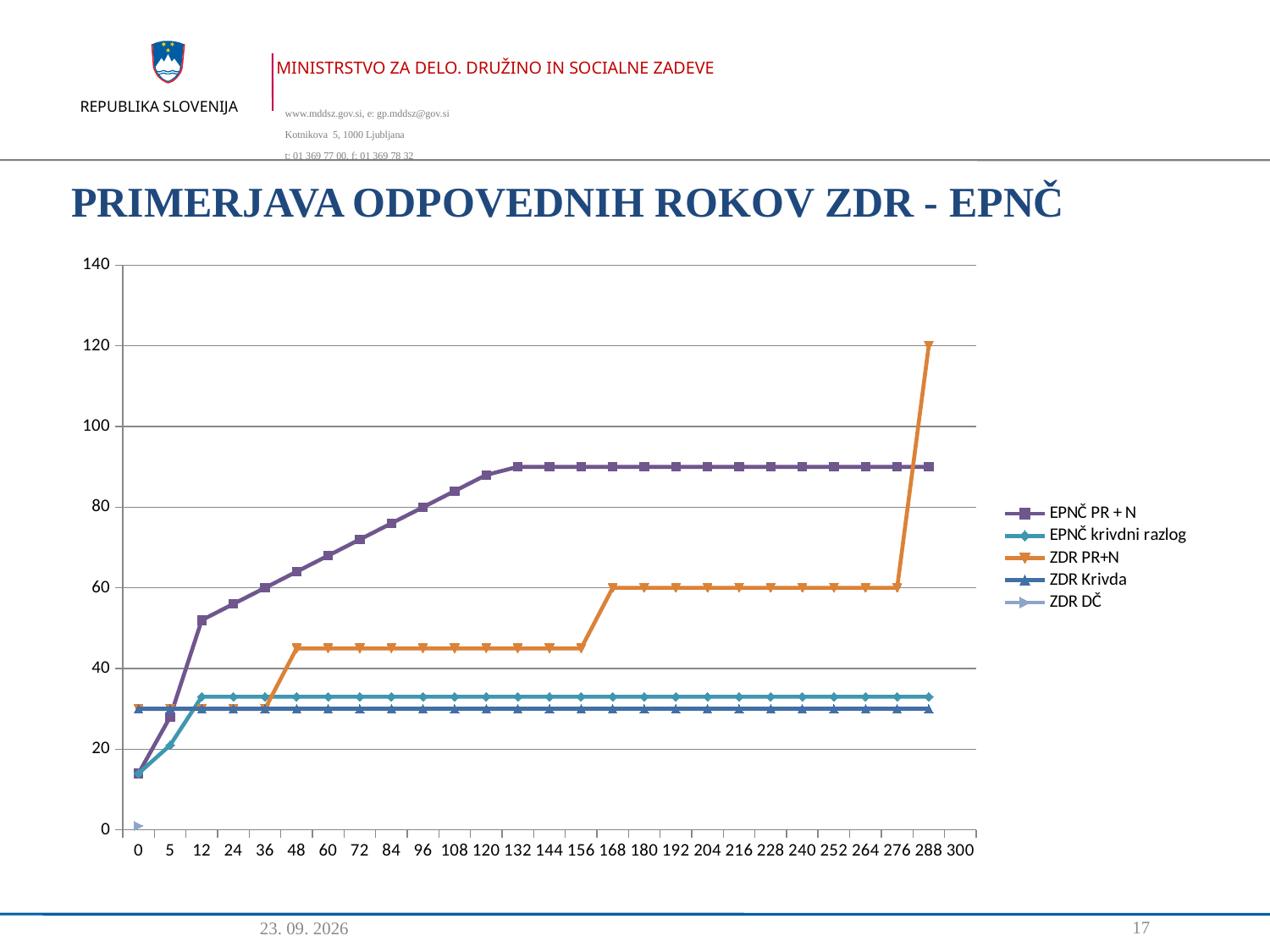
What is the value of EPNČ PR + N at x = 36? 60 Is the value of ZDR Krivda at x = 120 greater or less than 40? less Which series reaches the highest value on the chart? ZDR PR+N What type of chart is shown on the slide? line chart What is the value of EPNČ PR + N at x = 96? 80 How many series does the legend list? 5 What is the title of the chart? PRIMERJAVA ODPOVEDNIH ROKOV ZDR - EPNČ Does the EPNČ PR + N series rise or fall between x = 0 and x = 132? rise At x = 240, which is larger: EPNČ PR + N or ZDR PR+N? EPNČ PR + N What is the value of ZDR PR+N at x = 288? 120 What is the value of ZDR PR+N at x = 180? 60